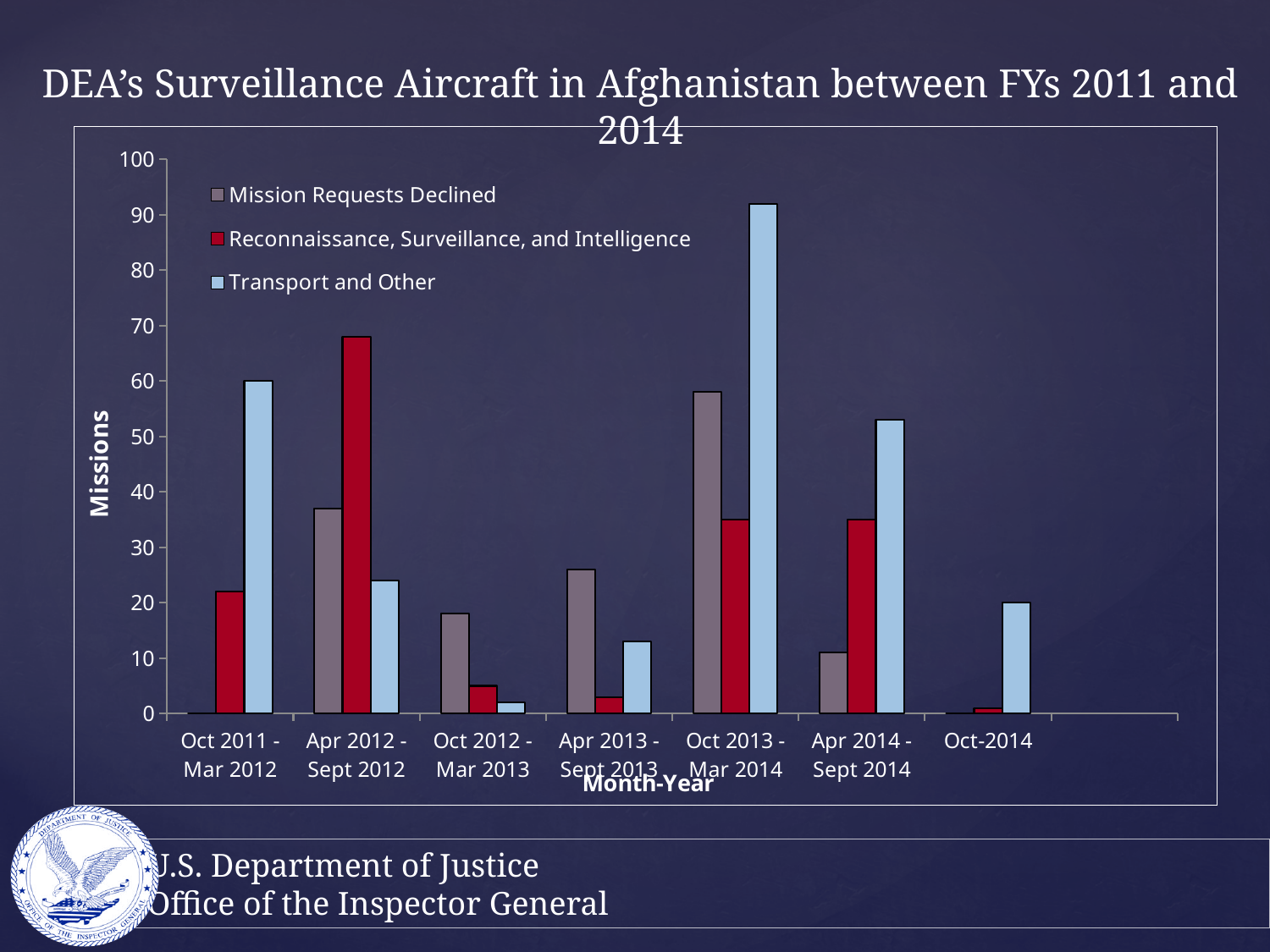
Which period has the highest value for Reconnaissance, Surveillance, and Intelligence? Apr 2012 - Sept 2012 Is the value for Mission Requests Declined in Apr 2013 - Sept 2013 greater or less than 30? less In Apr 2012 - Sept 2012, which is larger: Reconnaissance, Surveillance, and Intelligence or Mission Requests Declined? Reconnaissance, Surveillance, and Intelligence Which period has the lowest value for Transport and Other? Oct 2012 - Mar 2013 Is the value for Transport and Other in Oct 2013 - Mar 2014 greater or less than 80? greater Which period has the highest value for Mission Requests Declined? Oct 2013 - Mar 2014 How many series does the legend list? 3 Is the value for Reconnaissance, Surveillance, and Intelligence in Apr 2012 - Sept 2012 greater or less than 60? greater Which period has the highest value for Transport and Other? Oct 2013 - Mar 2014 What is the title of the y axis? Missions How many Month-Year periods are shown on the x axis? 7 What kind of chart is shown on the slide? bar chart